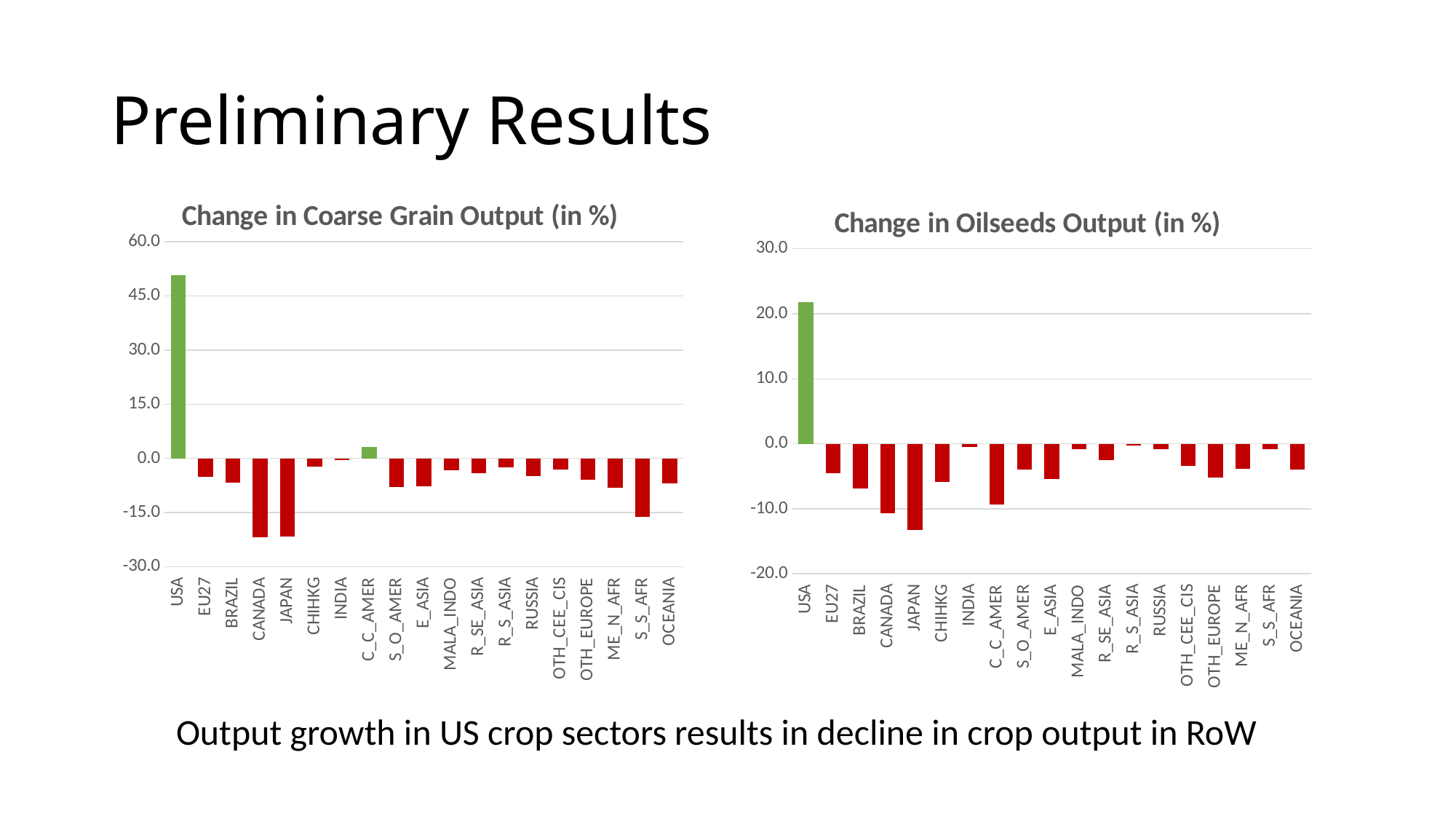
What kind of chart is the 'Change in Coarse Grain Output (in %)' chart? bar chart In the 'Change in Coarse Grain Output (in %)' chart, is the value for CANADA greater or less than -15.0? less In the 'Change in Oilseeds Output (in %)' chart, is the value for BRAZIL greater or less than -10.0? greater In the 'Change in Coarse Grain Output (in %)' chart, what colour are the bars with positive values? green In the 'Change in Oilseeds Output (in %)' chart, is the value for USA greater or less than 20.0? greater In the 'Change in Oilseeds Output (in %)' chart, which region has the highest value? USA In the 'Change in Oilseeds Output (in %)' chart, which has the larger value, EU27 or BRAZIL? EU27 In the 'Change in Coarse Grain Output (in %)' chart, which region has the highest value? USA How many regions are shown on the x axis of the 'Change in Coarse Grain Output (in %)' chart? 19 In the 'Change in Oilseeds Output (in %)' chart, which region has the lowest value? JAPAN